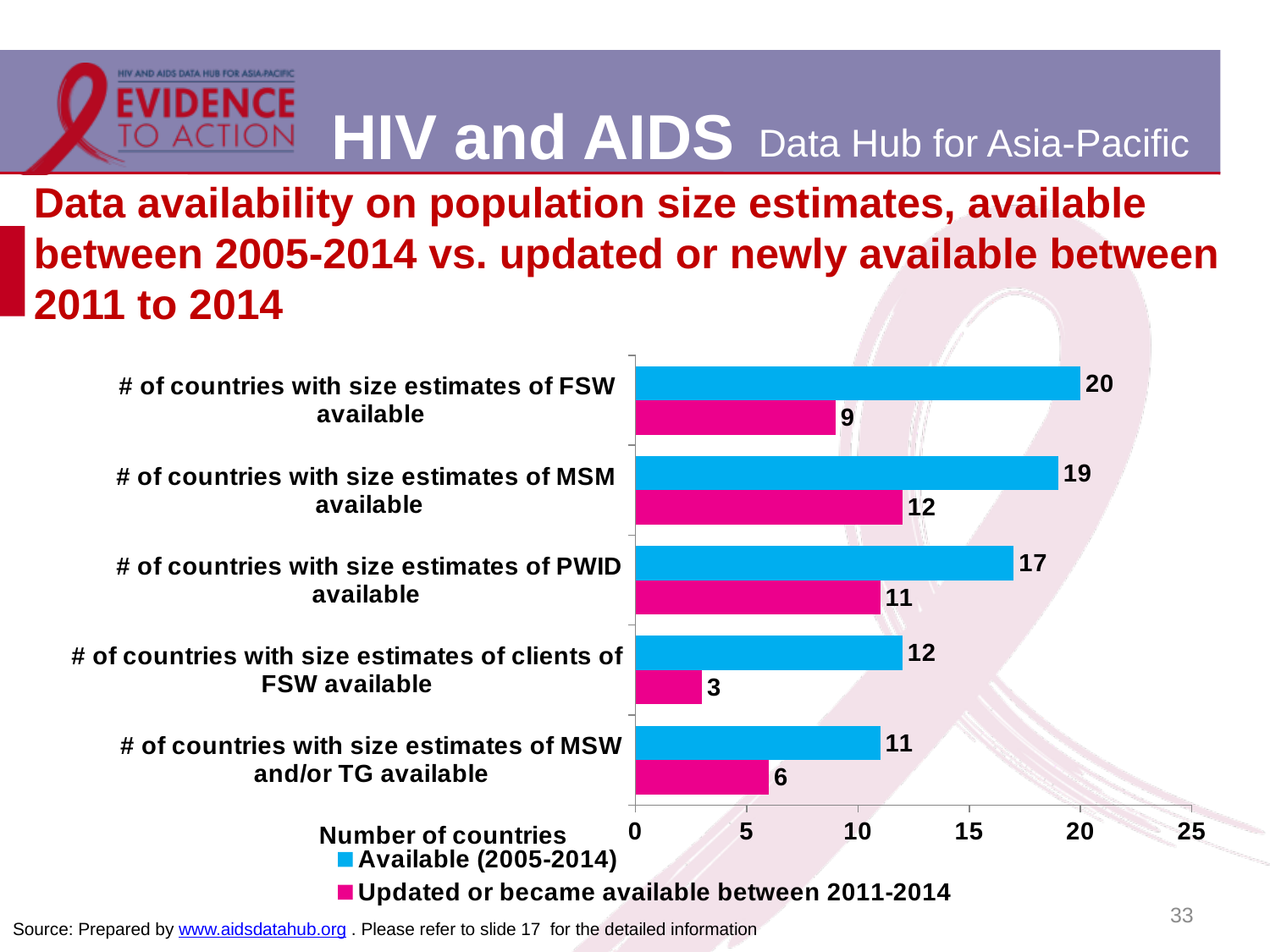
What is the label of the horizontal axis? Number of countries What kind of chart is shown on the slide? Bar chart Which category has the lowest value for the 'Updated or became available between 2011-2014' series? # of countries with size estimates of clients of FSW available Which colour represents the 'Available (2005-2014)' series? Blue What is the value for 'Updated or became available between 2011-2014' for the number of countries with size estimates of MSM available? 12 How many series does the legend list? 2 Which is larger: the 'Available (2005-2014)' value for MSW and/or TG or the 'Updated or became available between 2011-2014' value for MSM? Updated or became available between 2011-2014 value for MSM What is the value for 'Available (2005-2014)' for the number of countries with size estimates of FSW available? 20 What is the difference between the 'Available (2005-2014)' and 'Updated or became available between 2011-2014' values for countries with size estimates of PWID available? 6 What is the value for 'Updated or became available between 2011-2014' for the number of countries with size estimates of clients of FSW available? 3 How many categories are shown on the chart? 5 Which category has the highest value for the 'Available (2005-2014)' series? # of countries with size estimates of FSW available